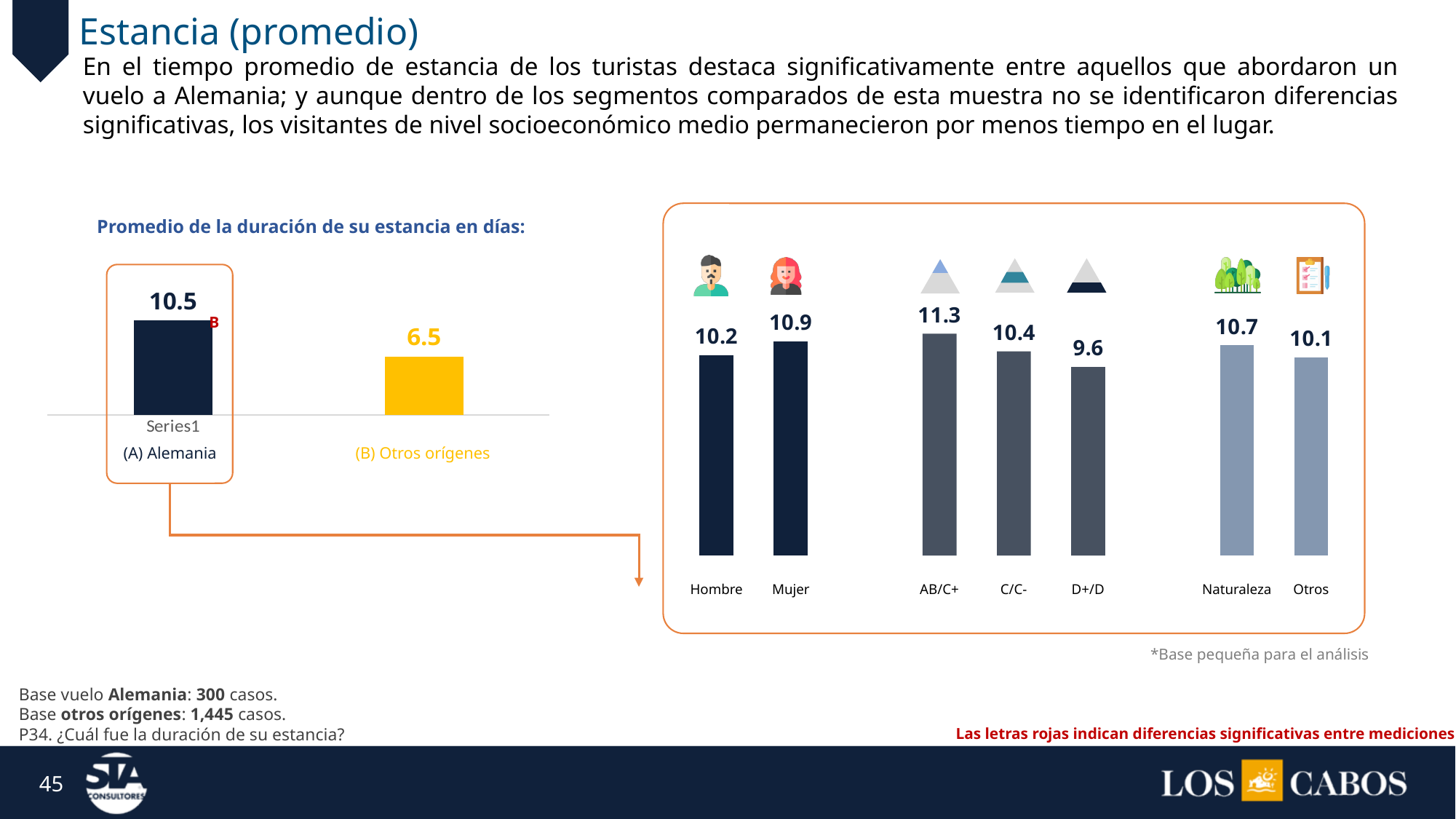
In the right chart inside the orange box, what is the difference between AB/C+ and D+/D? 1.7 In the right chart inside the orange box, which category has the highest value? AB/C+ In the right chart inside the orange box, what is the value for Mujer? 10.9 In the right chart inside the orange box, which category has the lowest value? D+/D What kind of chart is the left chart 'Promedio de la duración de su estancia en días'? Bar chart In the left chart 'Promedio de la duración de su estancia en días', what is the value for (A) Alemania? 10.5 In the left chart 'Promedio de la duración de su estancia en días', what is the value for (B) Otros orígenes? 6.5 In the right chart inside the orange box, what is the value for D+/D? 9.6 In the right chart inside the orange box, which has the larger value, Naturaleza or Otros? Naturaleza In the right chart inside the orange box, how many categories are shown? 7 In the left chart 'Promedio de la duración de su estancia en días', which category has the higher value, (A) Alemania or (B) Otros orígenes? (A) Alemania In the left chart 'Promedio de la duración de su estancia en días', what is the difference between (A) Alemania and (B) Otros orígenes? 4.0